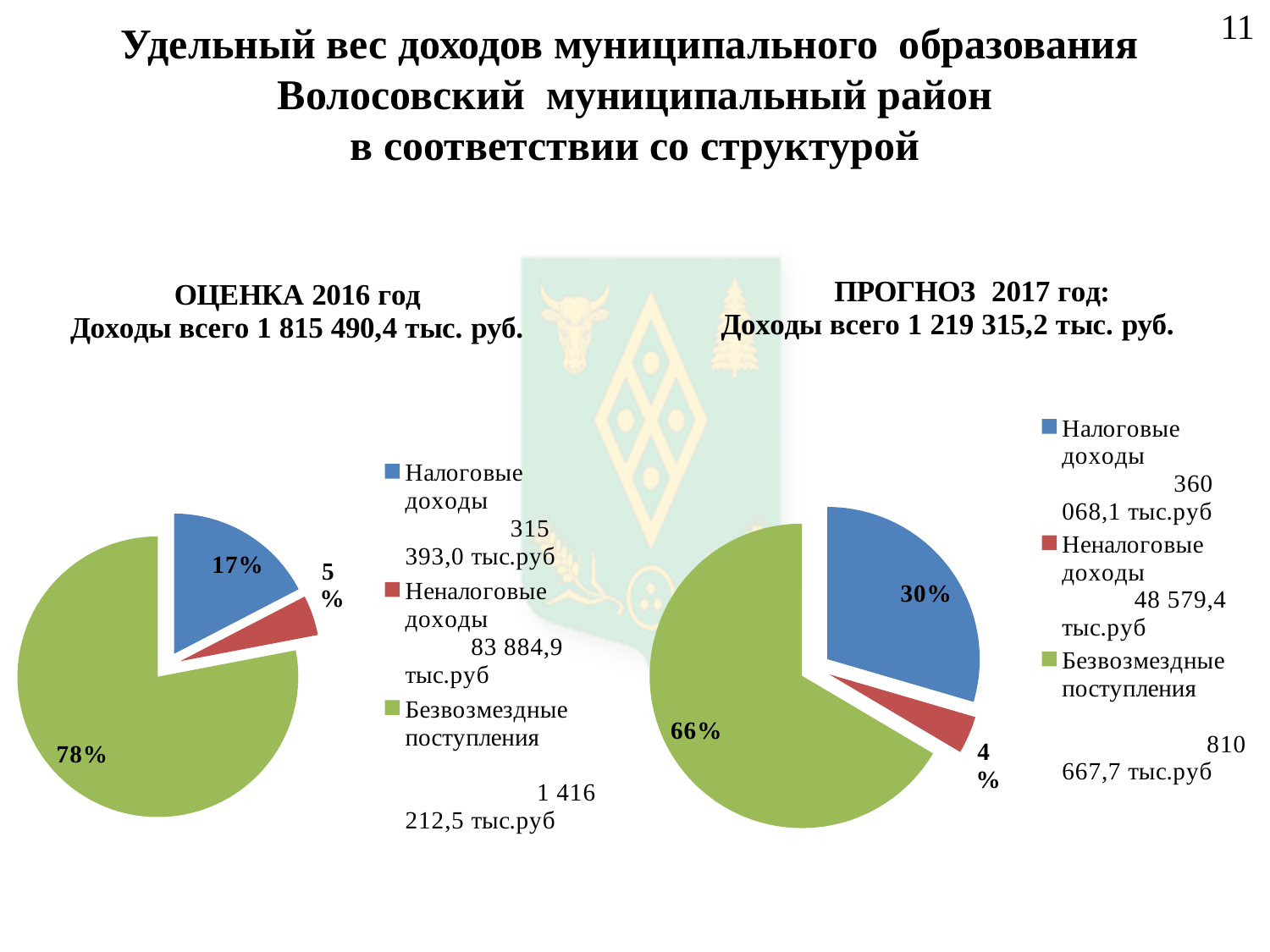
According to the legend of the left chart (ОЦЕНКА 2016 год), what amount is given for Неналоговые доходы? 83 884,9 тыс.руб In the left pie chart (ОЦЕНКА 2016 год), what share is shown for Безвозмездные поступления? 78% How many entries does the legend of the right pie chart (ПРОГНОЗ 2017 год) list? 3 In the right pie chart (ПРОГНОЗ 2017 год), which category has the smallest slice? Неналоговые доходы In the left pie chart (ОЦЕНКА 2016 год), what is the difference in percentage points between Безвозмездные поступления and Налоговые доходы? 61 percentage points In the left pie chart (ОЦЕНКА 2016 год), what share is shown for Налоговые доходы? 17% What type of chart is used on this slide? Pie chart In the right pie chart (ПРОГНОЗ 2017 год), what share is shown for Неналоговые доходы? 4% Which is larger: the share of Налоговые доходы in the left chart (ОЦЕНКА 2016 год) or in the right chart (ПРОГНОЗ 2017 год)? Right chart (ПРОГНОЗ 2017 год) In the left pie chart (ОЦЕНКА 2016 год), which category has the largest slice? Безвозмездные поступления How many slices does the left pie chart (ОЦЕНКА 2016 год) have? 3